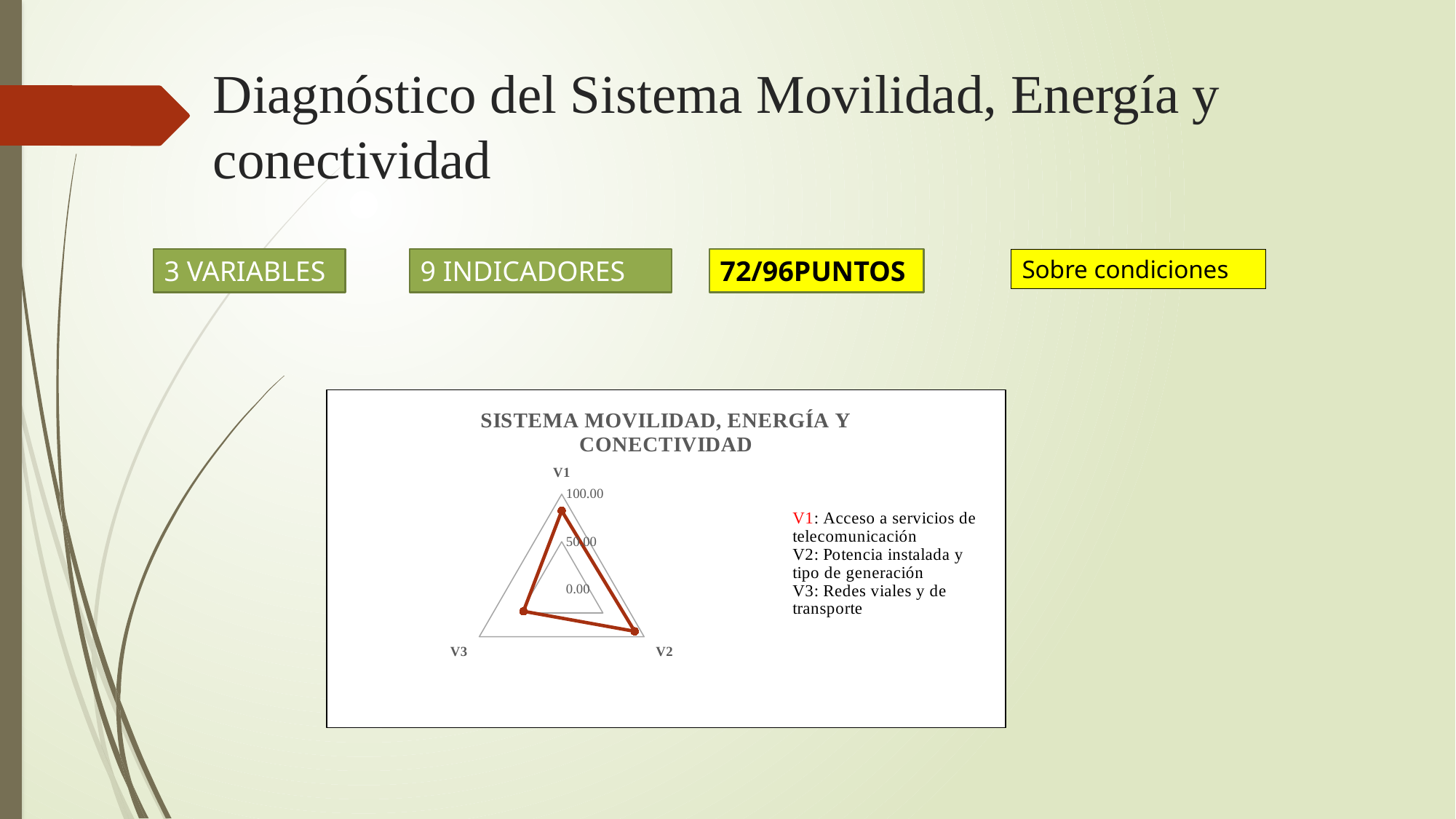
Is the value for V2 greater or less than 50.00? greater Which variable has the lowest value in the radar chart? V3 What kind of chart is shown on the slide? Radar chart How many variables (axes) does the radar chart plot? 3 Which is larger, the value for V2 or the value for V3? V2 Is the value for V1 greater or less than 50.00? greater Which variable has the highest value in the radar chart? V2 What is the title of the radar chart? SISTEMA MOVILIDAD, ENERGÍA Y CONECTIVIDAD Which is larger, the value for V1 or the value for V3? V1 Is the value for V3 greater or less than 100.00? less What is the maximum value shown on the radar chart's scale? 100.00